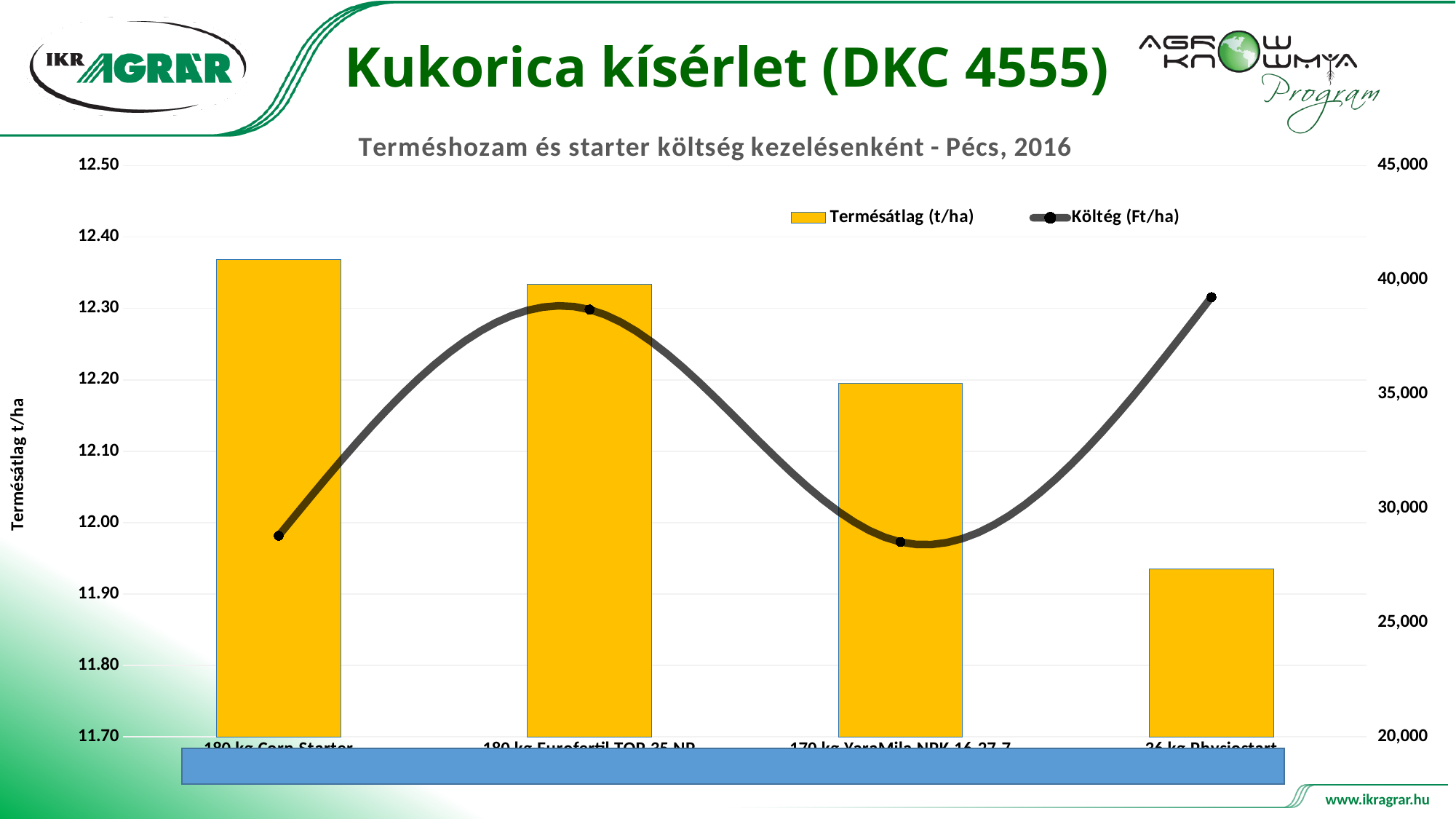
How many series does the chart legend list? 2 What is the title of the chart? Terméshozam és starter költség kezelésenként - Pécs, 2016 Is the Termésátlag value for 170 kg YaraMila NPK 16-27-7 greater or less than 12.10? greater Which treatment has the lowest Termésátlag (t/ha) bar? 36 kg Physiostart Is the Költég (Ft/ha) value for 180 kg Eurofertil TOP 35 NP greater or less than 35,000? greater What kind of chart is this? Combined bar and line chart How many treatment categories are shown on the x axis? 4 Do the Termésátlag (t/ha) bars rise or fall from left to right across the x axis? fall Which treatment has the highest Termésátlag (t/ha) bar? 180 kg Corn Starter Is the Termésátlag value for 36 kg Physiostart greater or less than 12.00? less